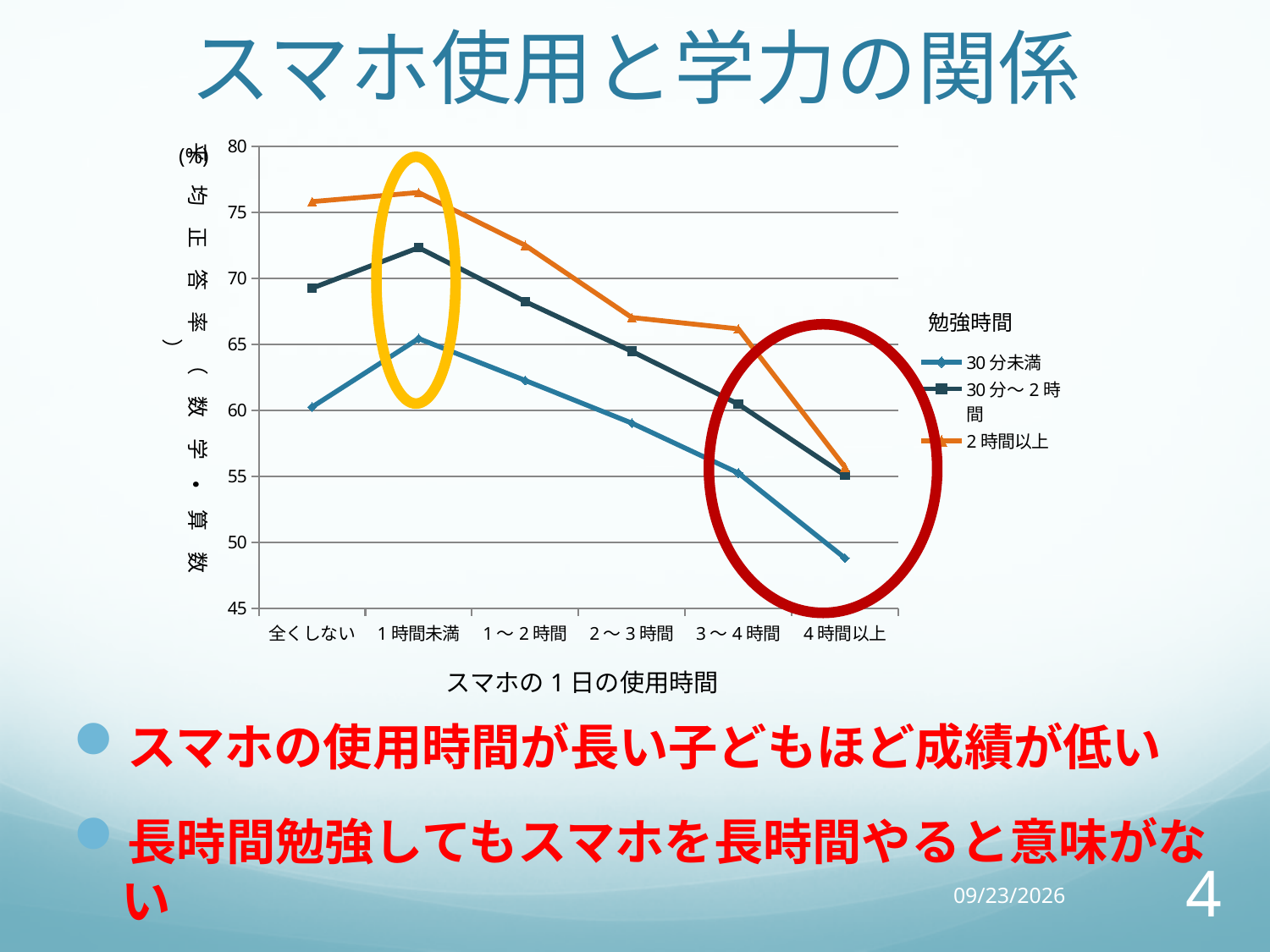
How many series does the legend list? 3 Is the value for 30分～2時間 at 4時間以上 greater or less than 60? less What kind of chart is shown on the slide? line chart For the 30分未満 series, which smartphone usage category has the lowest value? 4時間以上 For the 30分未満 series, which smartphone usage category has the highest value? 1時間未満 For the 30分～2時間 series, which smartphone usage category has the highest value? 1時間未満 From 1時間未満 to 4時間以上, do the values of the 2時間以上 series rise or fall? fall Is the value for 2時間以上 at 1時間未満 greater or less than 75? greater At 全くしない, which series has the larger value, 2時間以上 or 30分未満? 2時間以上 What is the title of the legend? 勉強時間 Is the value for 30分未満 at 4時間以上 greater or less than 50? less How many categories are on the x axis? 6